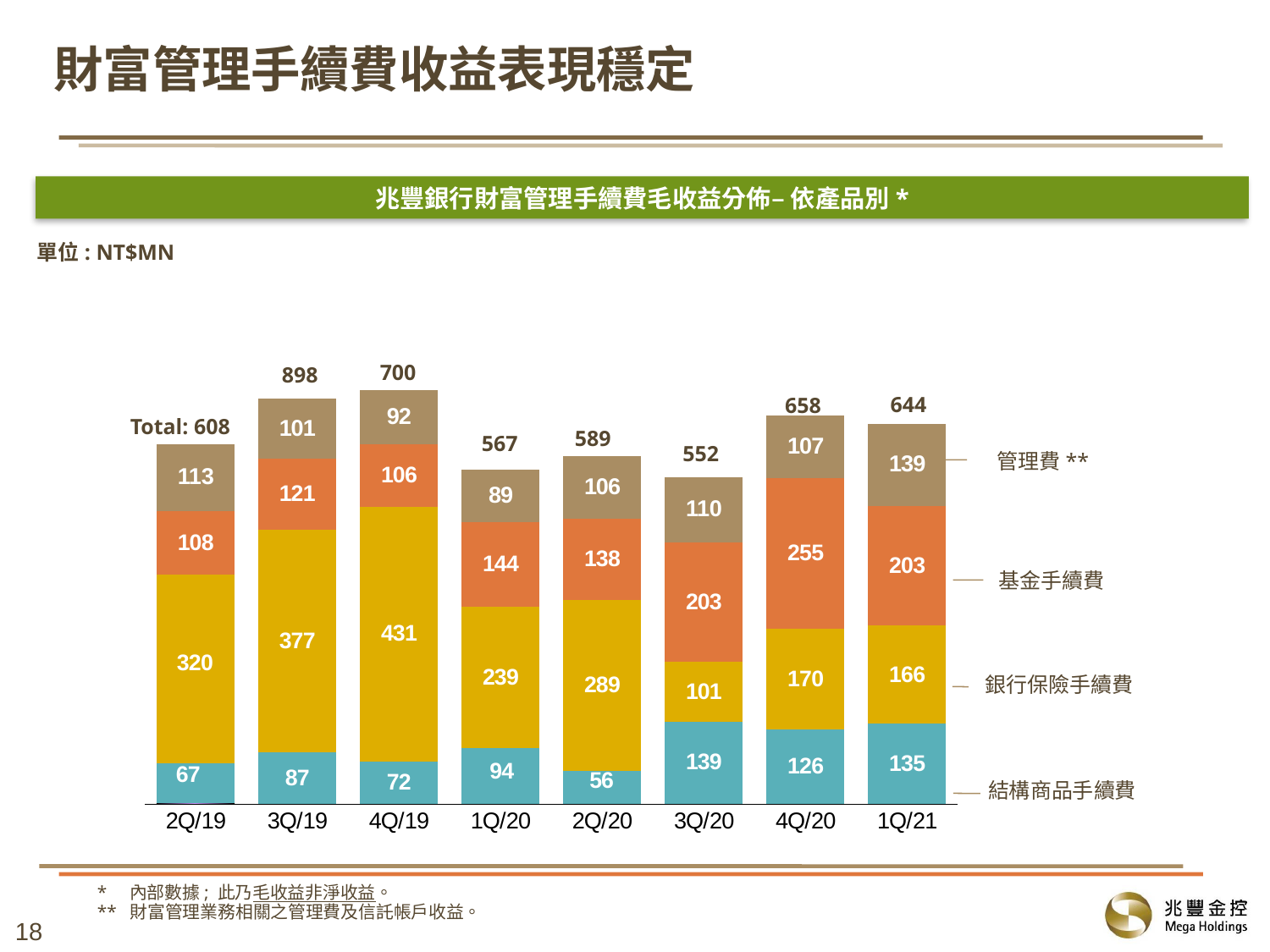
What is the 管理費 value for 1Q/21? 139 Which quarter has the lowest total? 3Q/20 How many quarters are shown on the x axis of the chart? 8 How many series (product categories) are labelled on the chart? 4 What type of chart is shown on the slide? stacked bar chart What is the 結構商品手續費 value for 2Q/20? 56 Which is larger, the 基金手續費 value for 3Q/20 or for 1Q/21? They are equal (both 203) What is the difference between the totals for 4Q/20 and 1Q/21? 14 What is the total for 3Q/19? 898 What is the 基金手續費 value for 4Q/20? 255 What is the 銀行保險手續費 value for 4Q/19? 431